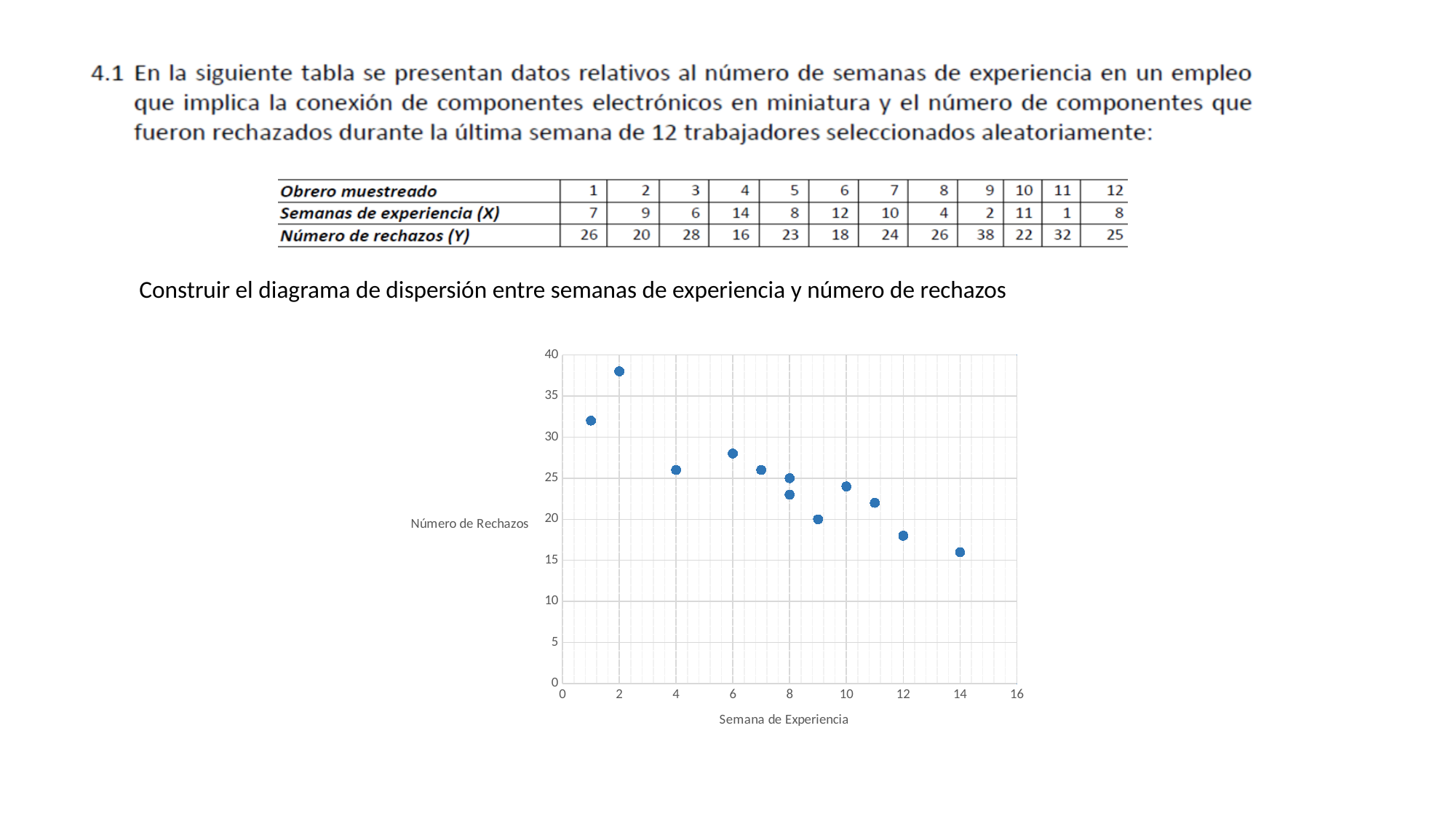
What is the title of the vertical axis of the chart? Número de Rechazos What is the number of rejections for the worker with 14 weeks of experience? 16 What is the number of rejections for the worker with 1 week of experience? 32 How many data points are plotted in the scatter chart? 12 At which number of weeks of experience is the number of rejections lowest? 14 Is the number of rejections at 6 weeks of experience greater or less than 25? greater What is the highest number of rejections plotted in the chart? 38 At which number of weeks of experience is the number of rejections highest? 2 What is the difference between the highest and lowest number of rejections plotted? 22 What is the title of the horizontal axis of the chart? Semana de Experiencia Do the number of rejections generally rise or fall as weeks of experience increase? Fall What kind of chart is shown on the slide? Scatter chart